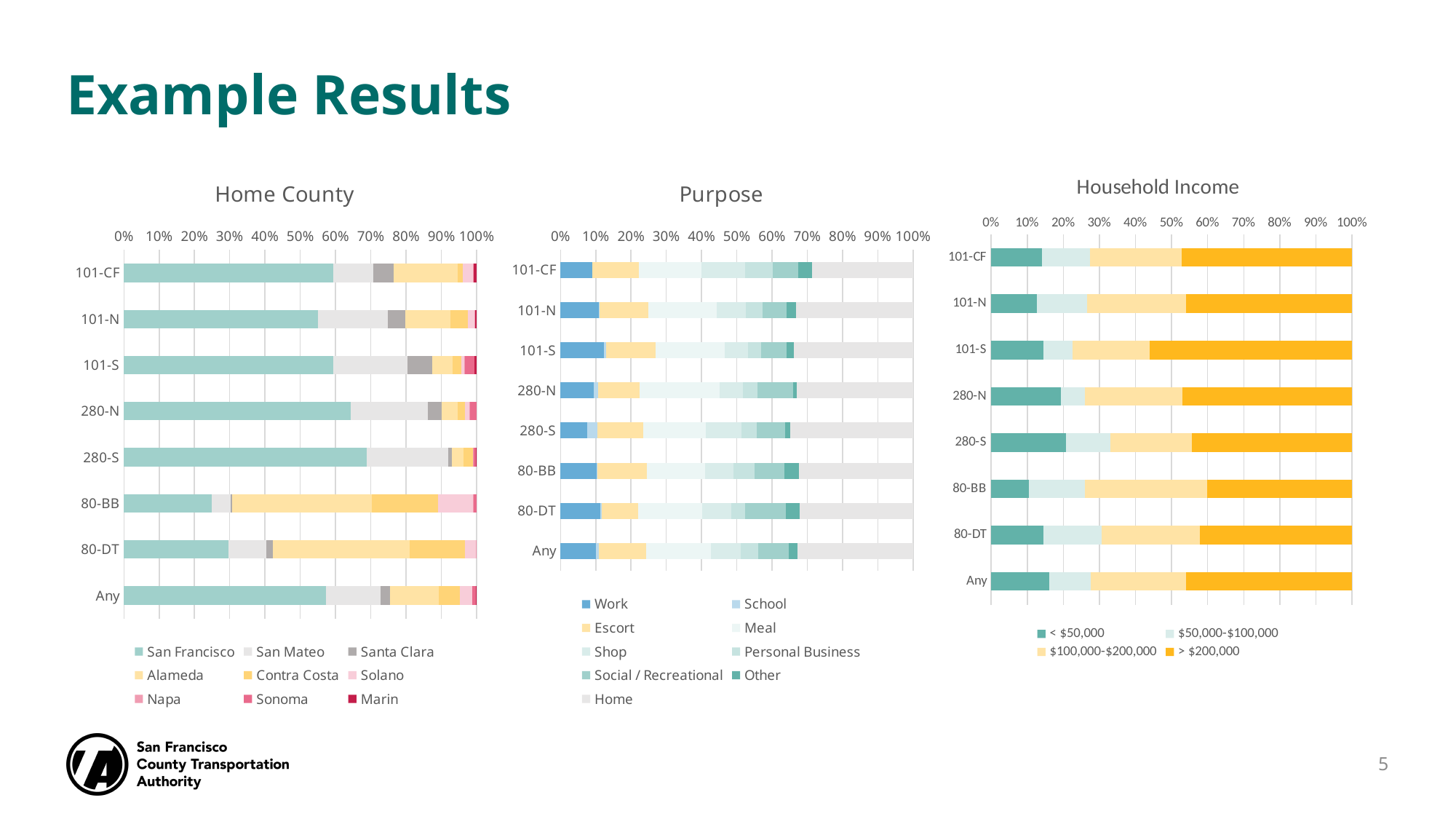
In the Purpose chart, is the Work share for 280-S greater or less than 10%? less In the Home County chart, which category has the smallest San Francisco share? 80-BB In the Home County chart, is the San Francisco share for 80-BB greater or less than 30%? less How many series does the legend of the Home County chart list? 9 In the Home County chart, which category has the largest San Francisco share? 280-S How many categories (bars) does the Purpose chart show? 8 In the Household Income chart, is the < $50,000 share for 280-S greater or less than 10%? greater In the Household Income chart, which category has the largest > $200,000 share? 101-S In the Household Income chart, which category has the smallest < $50,000 share? 80-BB How many series does the legend of the Household Income chart list? 4 What kind of chart is the Home County chart? stacked bar chart